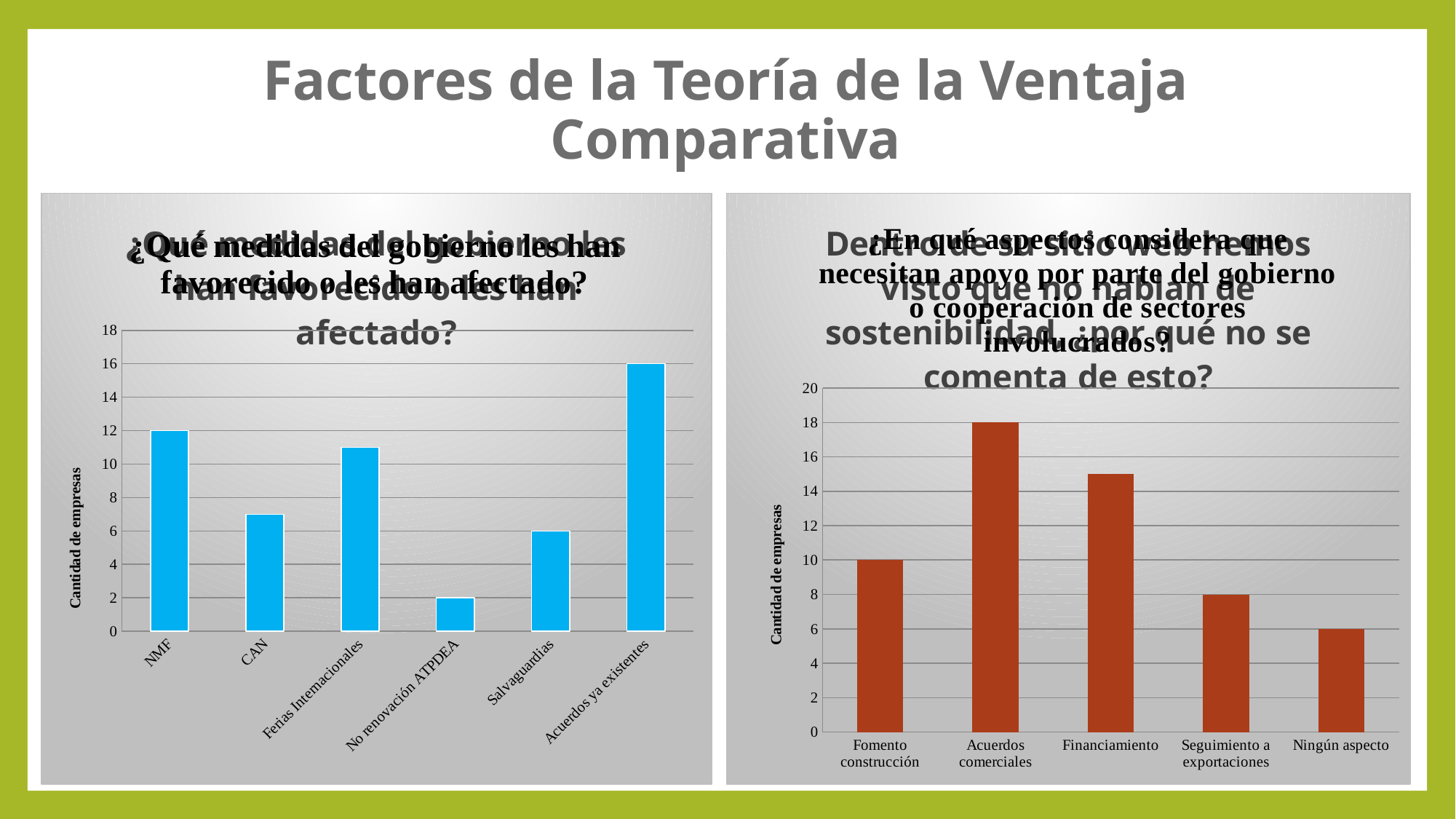
On the left chart, which category has the lowest value? No renovación ATPDEA On the left chart, which category has the highest value? Acuerdos ya existentes On the right chart, is the value for Financiamiento greater or less than 14? greater On the right chart, what is the value for Acuerdos comerciales? 18 On the left chart, what is the difference between Acuerdos ya existentes and Salvaguardias? 10 On the left chart, is the value for CAN greater or less than 8? less On the right chart, which category has the lowest value? Ningún aspecto On the right chart, which is larger, Fomento construcción or Seguimiento a exportaciones? Fomento construcción What type of chart is the right chart? bar chart On the left chart, how many categories are shown? 6 On the left chart, what is the value for Acuerdos ya existentes? 16 On the left chart, what is the value for NMF? 12